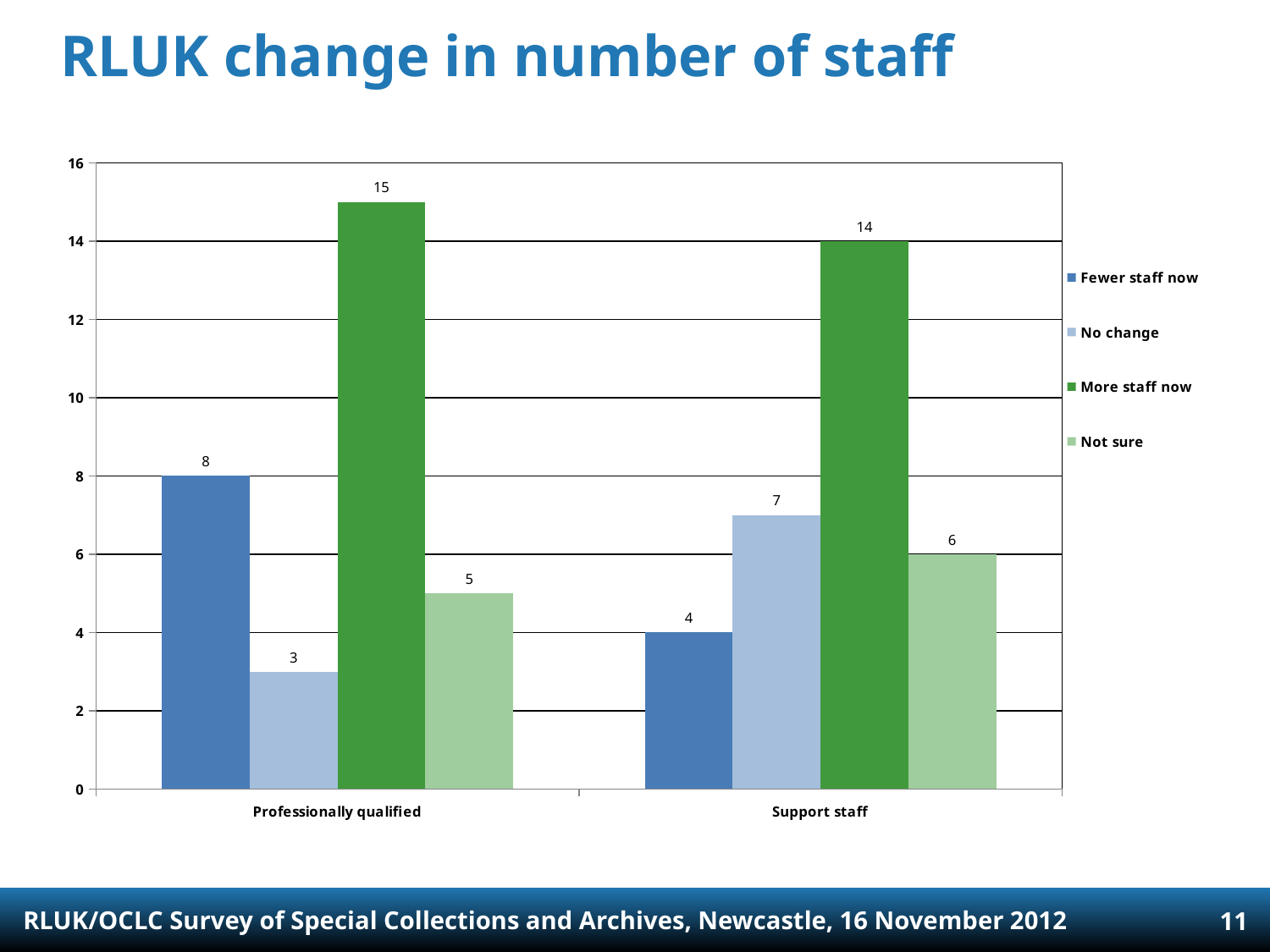
How many series does the legend list? 4 What is the difference between "Fewer staff now" for Professionally qualified and for Support staff? 4 What is the value for "More staff now" in the Professionally qualified category? 15 What is the title of the slide? RLUK change in number of staff How many categories are shown on the x axis? 2 What is the value for "No change" in the Support staff category? 7 Which is larger: "Not sure" for Professionally qualified or "Not sure" for Support staff? Support staff What is the value for "Fewer staff now" in the Support staff category? 4 Which series has the lowest value in the Professionally qualified category? No change What colour represents the "More staff now" series? Dark green Which series has the highest value in the Support staff category? More staff now What kind of chart is shown on the slide? Bar chart